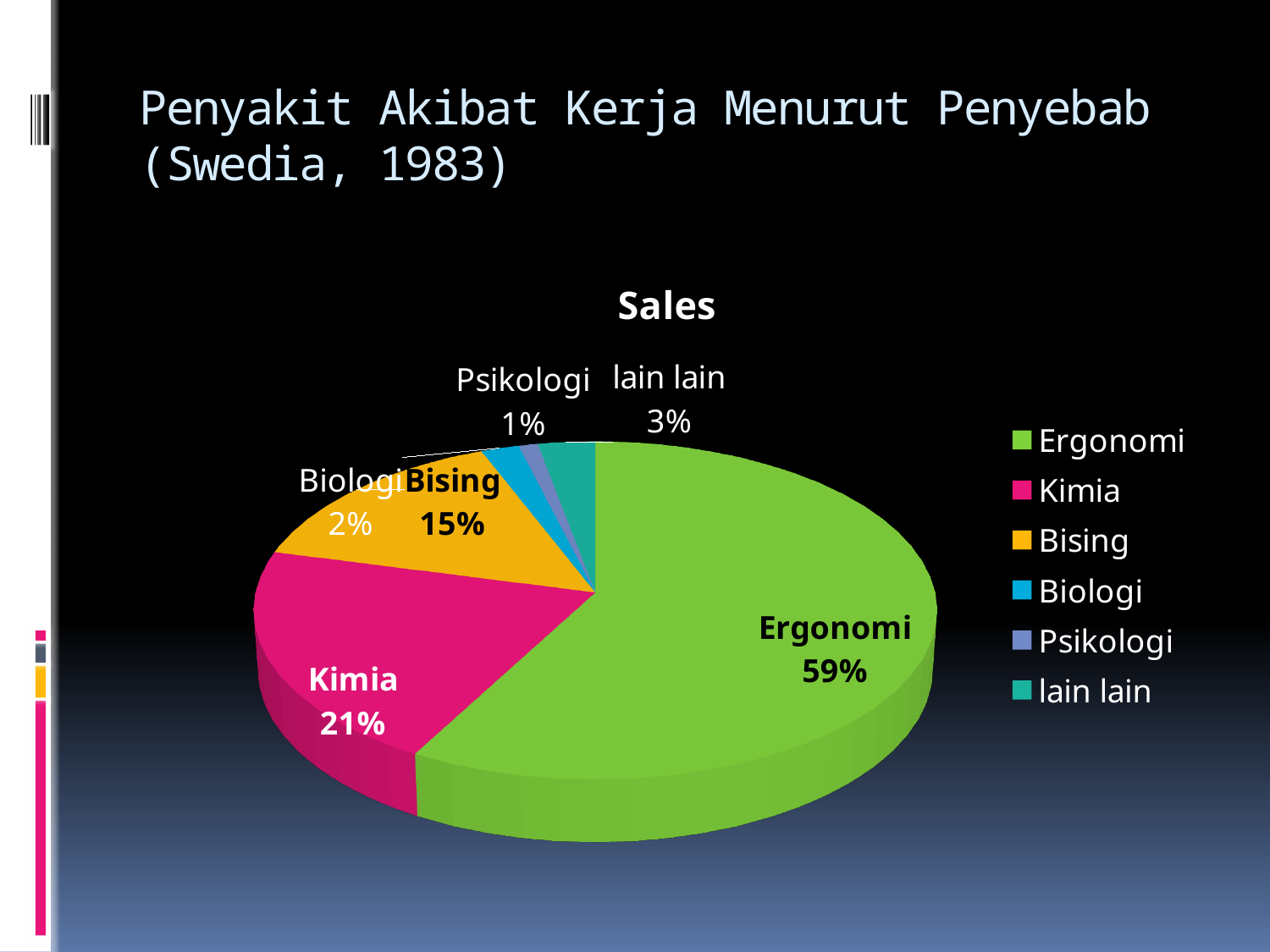
Which category has the largest share of the pie? Ergonomi Which category has the smallest share of the pie? Psikologi What is the difference in percentage points between Ergonomi and Kimia? 38 What percentage does the Bising slice represent? 15% What percentage does the lain lain slice represent? 3% What is the chart's title? Sales How many categories does the legend list? 6 What type of chart is shown on the slide? pie chart What percentage does the Kimia slice represent? 21% Which is larger, the Bising slice or the Kimia slice? Kimia What percentage does the Ergonomi slice represent? 59% What percentage does the Biologi slice represent? 2%